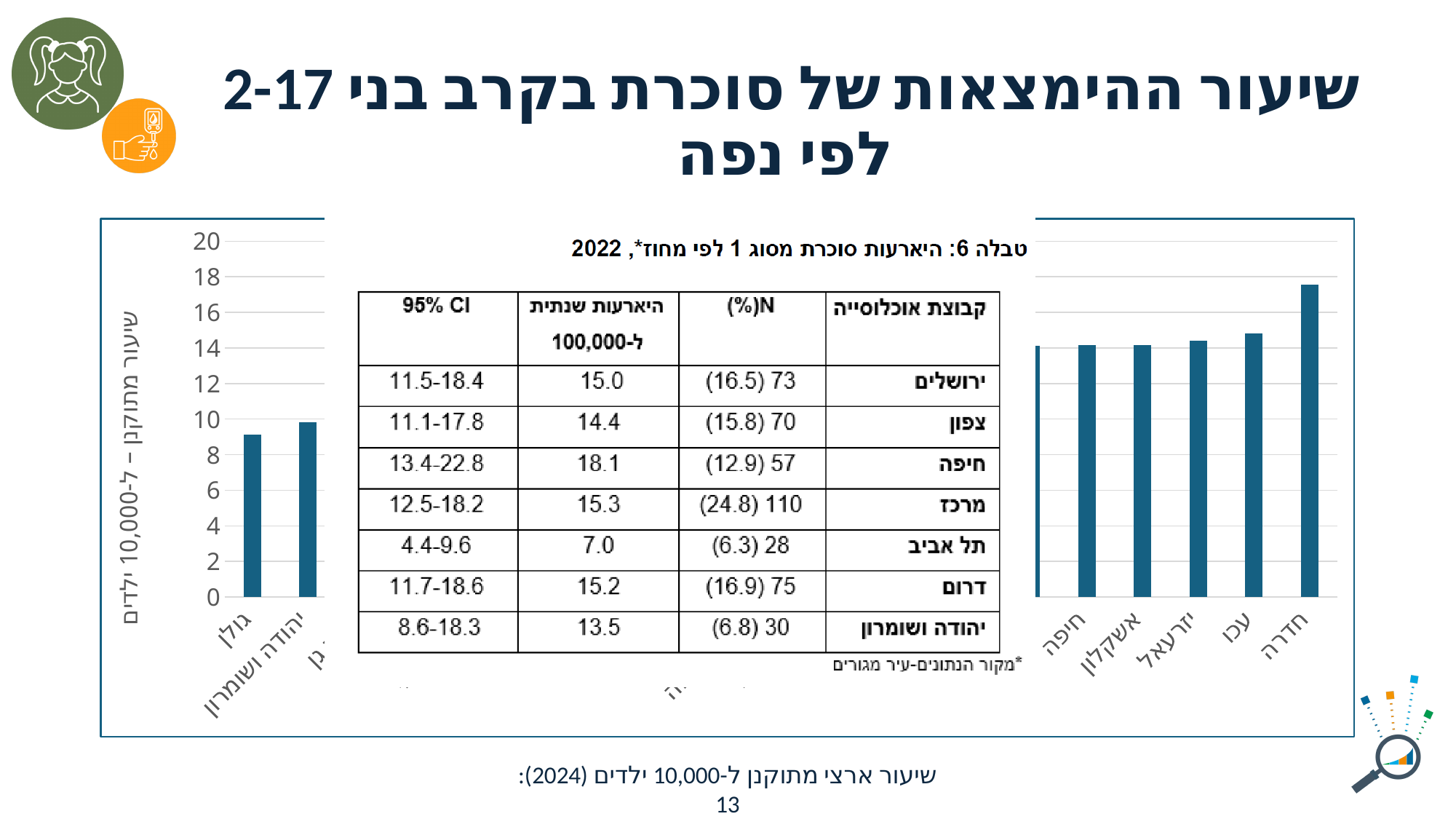
Which has a larger value, חדרה or עכו? חדרה Do the bar values rise or fall from left to right along the x axis? rise What kind of chart is shown on the slide? bar chart What is the label of the vertical axis of the chart? שיעור מתוקנן – ל-10,000 ילדים Is the value for עכו greater or less than 16? less Is the value for חדרה greater or less than 16? greater Is the value for גולן greater or less than 10? less Which has a larger value, חדרה or גולן? חדרה Which has a larger value, יהודה ושומרון or יזרעאל? יזרעאל